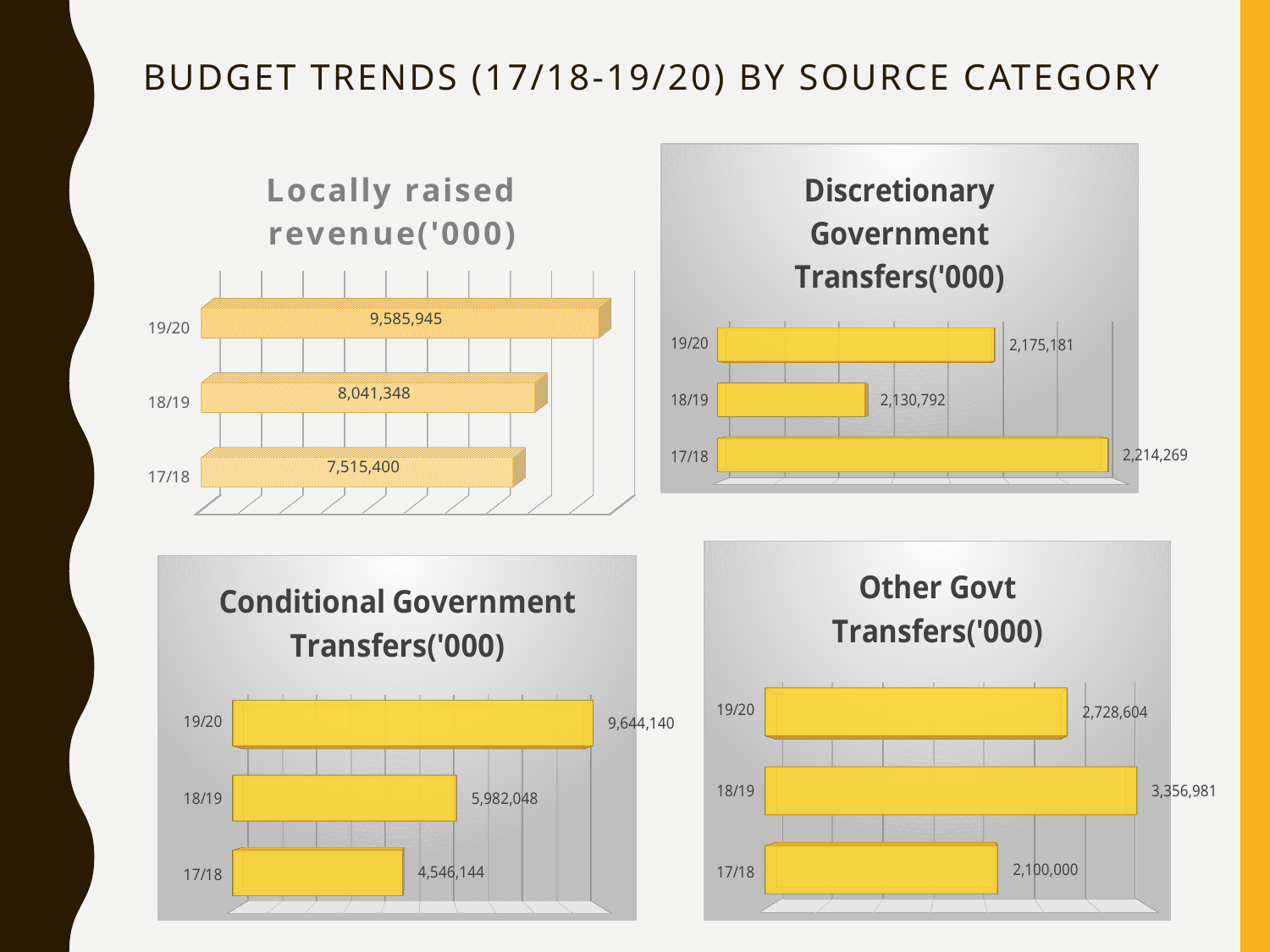
In the Other Govt Transfers('000) chart, which is larger, the value for 19/20 or the value for 17/18? 19/20 In the Locally raised revenue('000) chart, what is the difference between the 19/20 and 18/19 values? 1,544,597 In the Locally raised revenue('000) chart, what is the value for 19/20? 9,585,945 In the Discretionary Government Transfers('000) chart, what is the value for 18/19? 2,130,792 How many charts are shown on the slide? 4 In the Other Govt Transfers('000) chart, which year has the highest value? 18/19 In the Conditional Government Transfers('000) chart, do the values rise or fall from 17/18 to 19/20? Rise What kind of chart is the Locally raised revenue('000) chart? Bar chart In the Conditional Government Transfers('000) chart, what is the difference between the 19/20 and 17/18 values? 5,097,996 In the Conditional Government Transfers('000) chart, what is the value for 17/18? 4,546,144 In the Discretionary Government Transfers('000) chart, which year has the lowest value? 18/19 How many years are shown in the Conditional Government Transfers('000) chart? 3